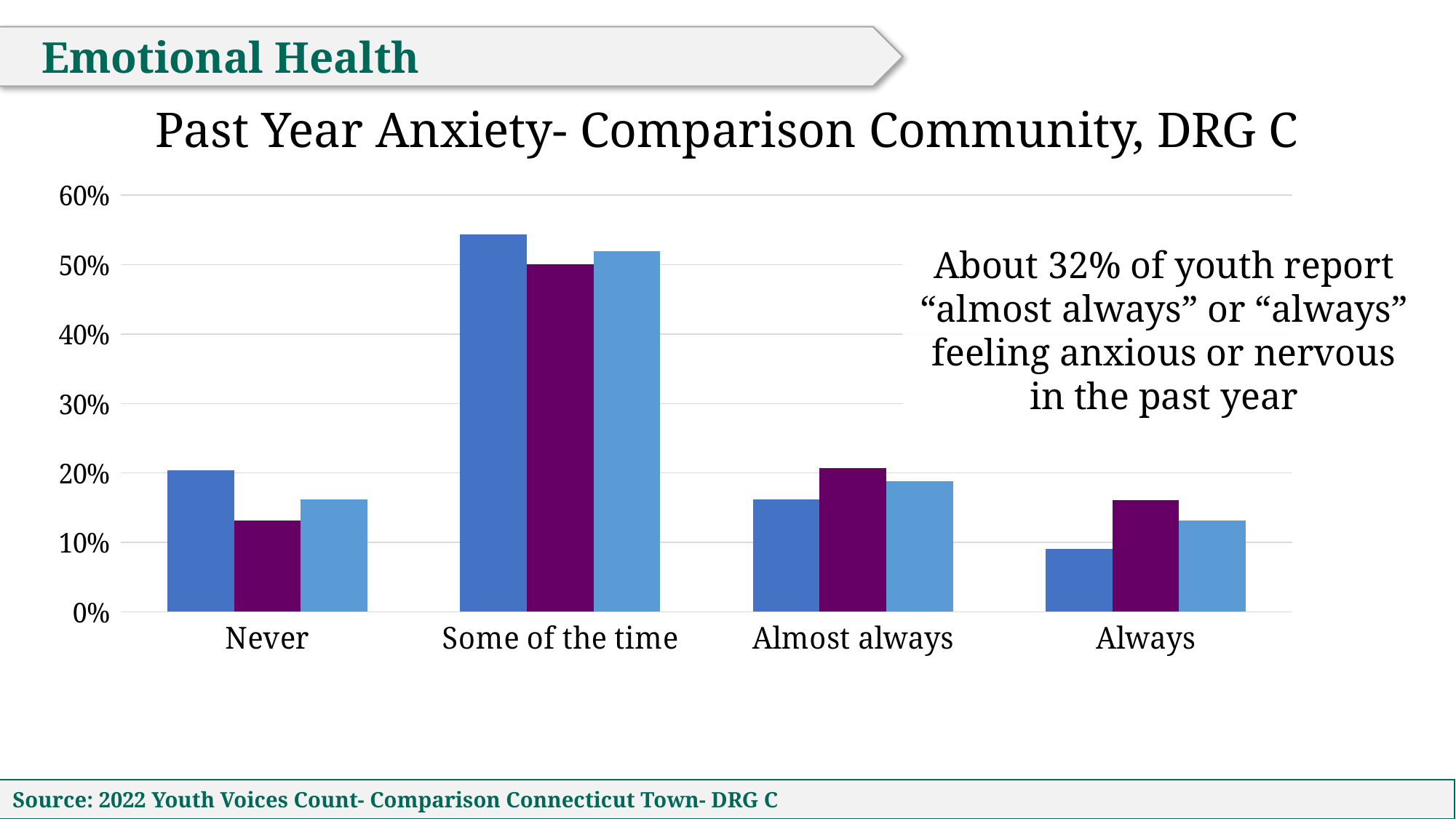
What kind of chart is shown on the slide? Bar chart Is the light blue bar for Almost always greater or less than 30%? less What is the title of the chart? Past Year Anxiety- Comparison Community, DRG C For the Always category, which is larger: the purple bar or the dark blue bar? The purple bar How many categories are shown on the x axis of the chart? 4 Which category has the highest bars in the chart? Some of the time How many bars are plotted for each category in the chart? 3 For the Never category, which is larger: the dark blue bar or the purple bar? The dark blue bar Is the purple bar for Never greater or less than 20%? less Is the dark blue bar for Some of the time greater or less than 50%? greater Which category has the lowest dark blue bar in the chart? Always